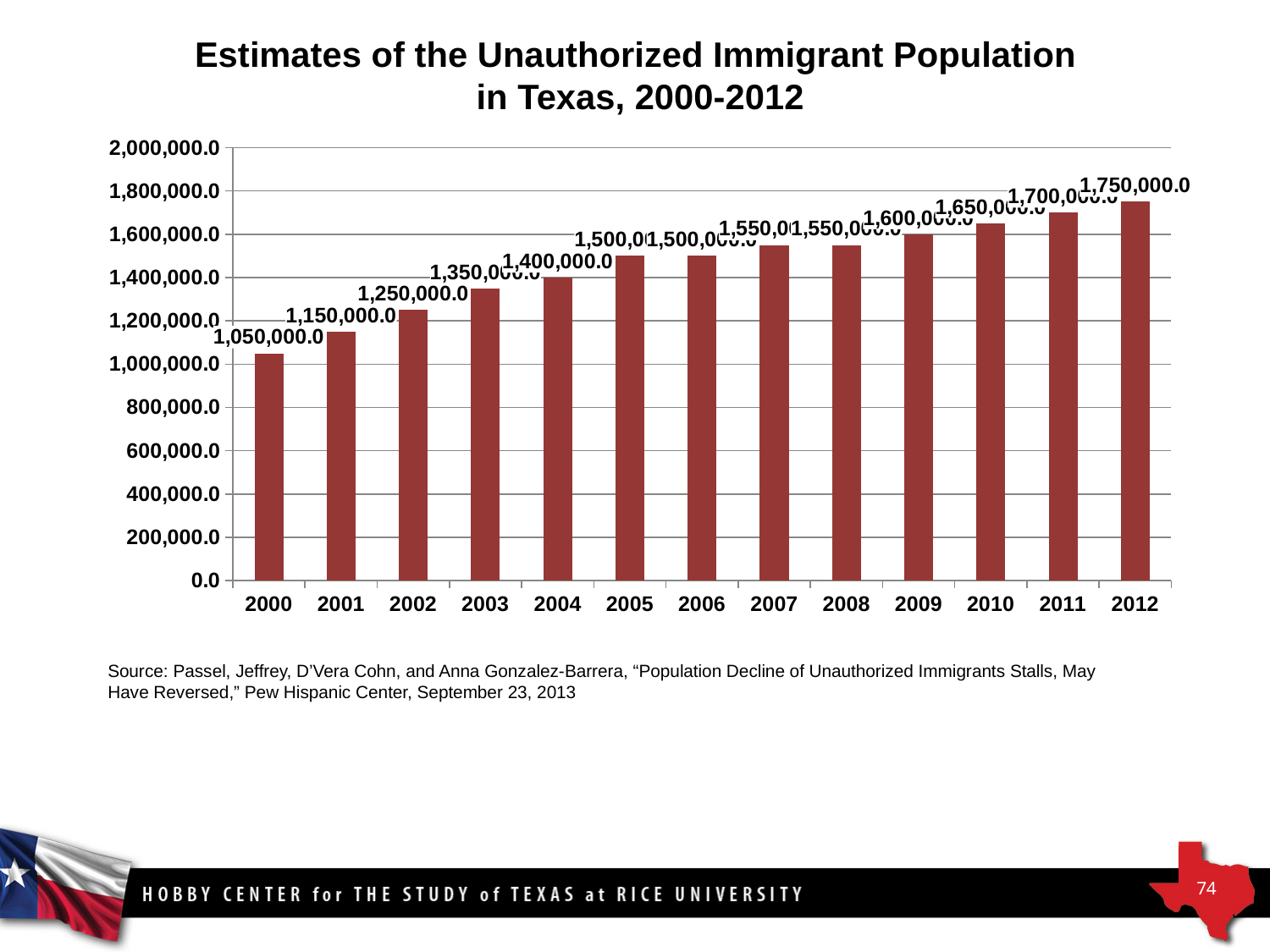
What type of chart is shown on the slide? bar chart How many years are shown on the x axis of the chart? 13 Is the value for 2007 greater or less than 1,600,000.0? less What is the estimated unauthorized immigrant population in Texas in 2010? 1,650,000.0 Do the values generally rise or fall from 2000 to 2012? rise Which year has the highest estimated unauthorized immigrant population? 2012 What is the difference between the estimated population in 2012 and in 2000? 700,000.0 What is the estimated unauthorized immigrant population in Texas in 2002? 1,250,000.0 What is the estimated unauthorized immigrant population in Texas in 2012? 1,750,000.0 Which year has the lowest estimated unauthorized immigrant population? 2000 What is the estimated unauthorized immigrant population in Texas in 2000? 1,050,000.0 Which year has a larger estimated population, 2004 or 2010? 2010